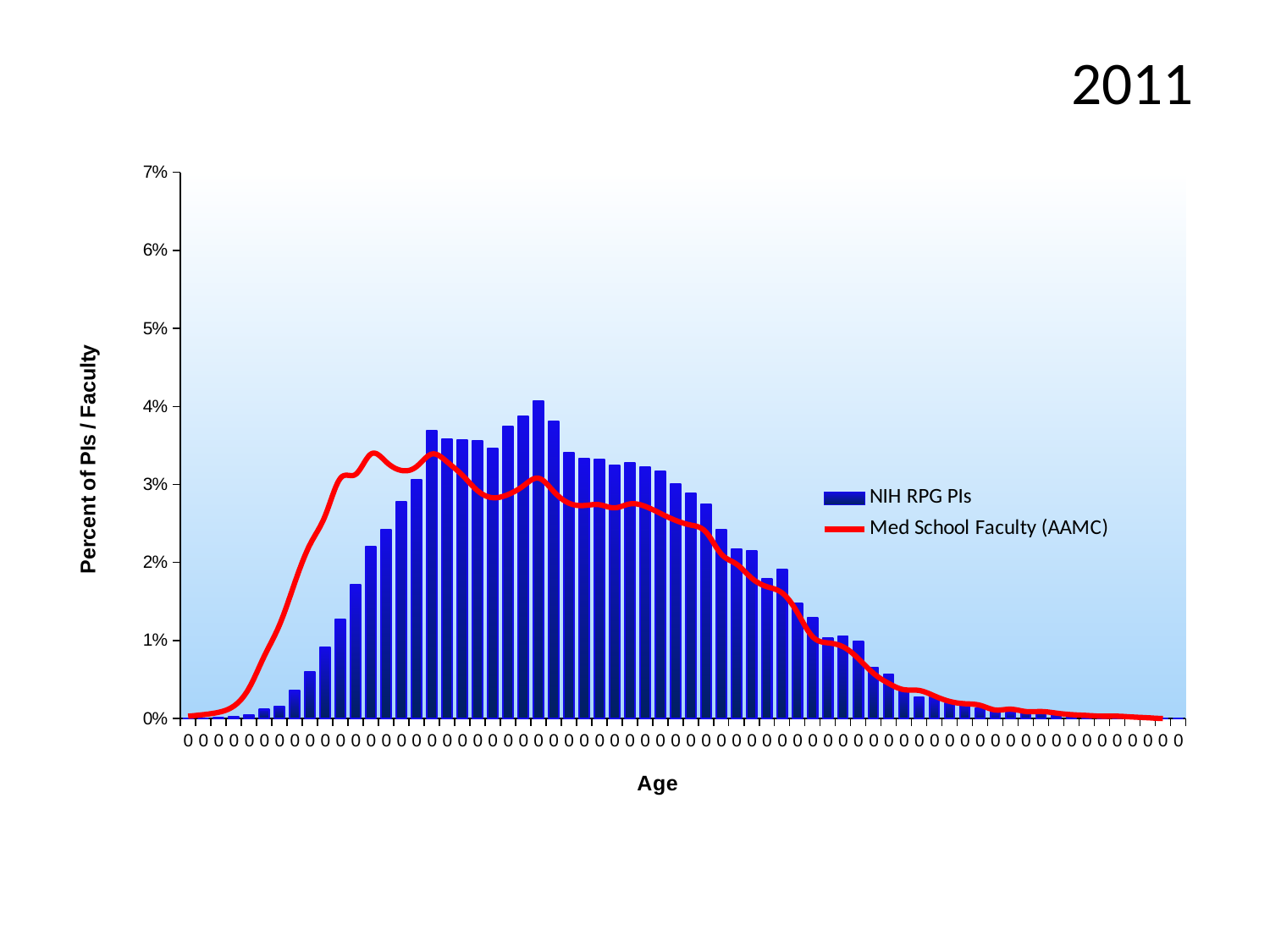
Which series reaches a higher peak value, NIH RPG PIs or Med School Faculty (AAMC)? NIH RPG PIs What are the two entries in the chart legend? NIH RPG PIs and Med School Faculty (AAMC) Do the NIH RPG PIs bar values rise or fall toward the right end of the x axis? fall Is the value of the tallest NIH RPG PIs bar greater or less than 3%? greater How many series does the legend list? 2 What kind of chart is shown on the slide? bar chart with a line overlay Is the value of the tallest NIH RPG PIs bar greater or less than 5%? less Is the highest point of the Med School Faculty (AAMC) line greater or less than 4%? less What is the title of the vertical axis? Percent of PIs / Faculty